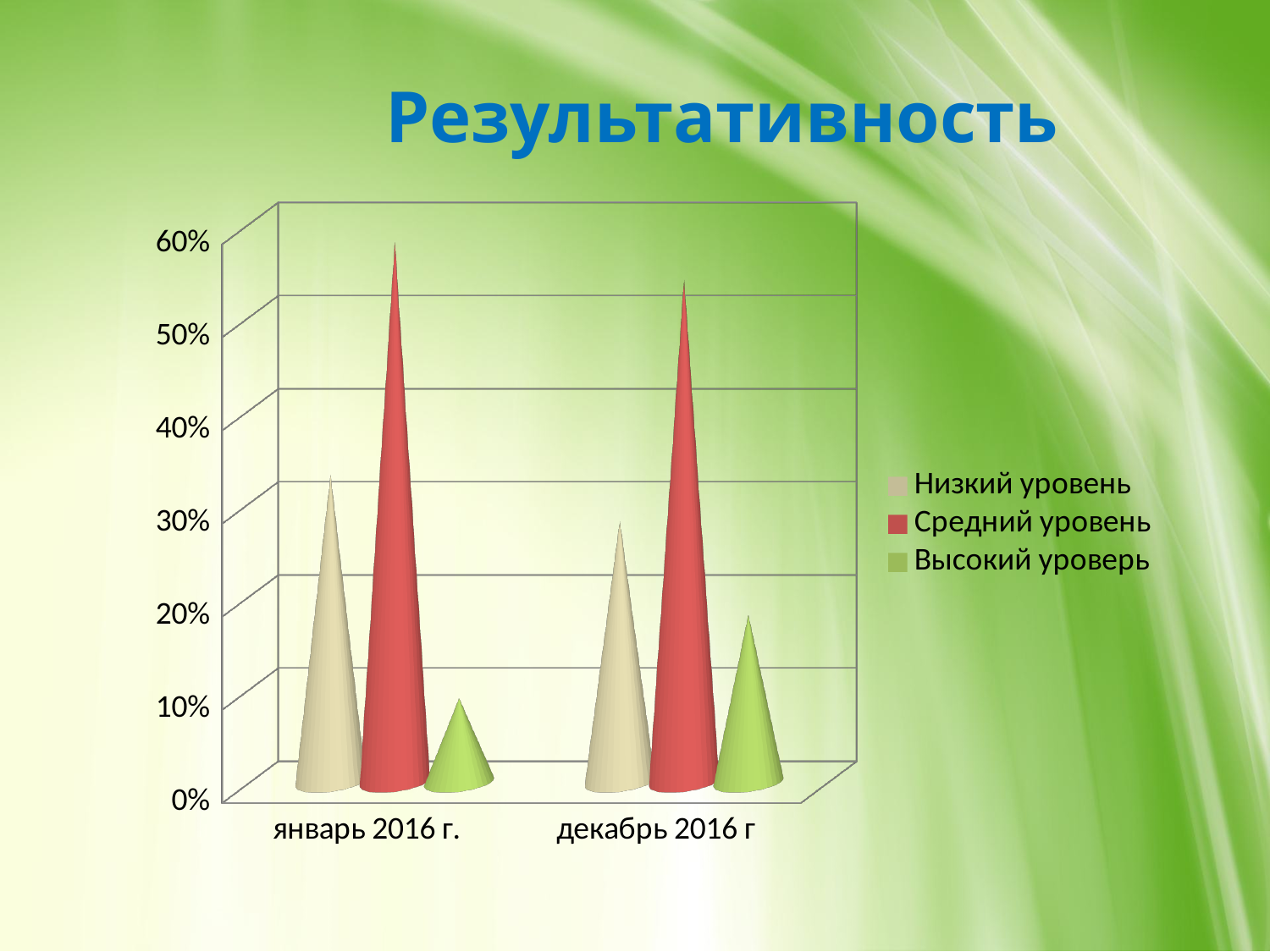
What is the title of the chart? Результативность How many categories are shown on the x axis? 2 Which is larger: Высокий уроверь for январь 2016 г. or for декабрь 2016 г? декабрь 2016 г How many series does the legend list? 3 Which series has the lowest value for январь 2016 г.? Высокий уроверь Does the value of Средний уровень rise or fall from январь 2016 г. to декабрь 2016 г? fall Is the value of Высокий уроверь for январь 2016 г. greater or less than 20%? less Is the value of Средний уровень for январь 2016 г. greater or less than 50%? greater Is the value of Средний уровень for декабрь 2016 г greater or less than 60%? less What kind of chart is shown on the slide? bar chart Which series has the highest value for январь 2016 г.? Средний уровень